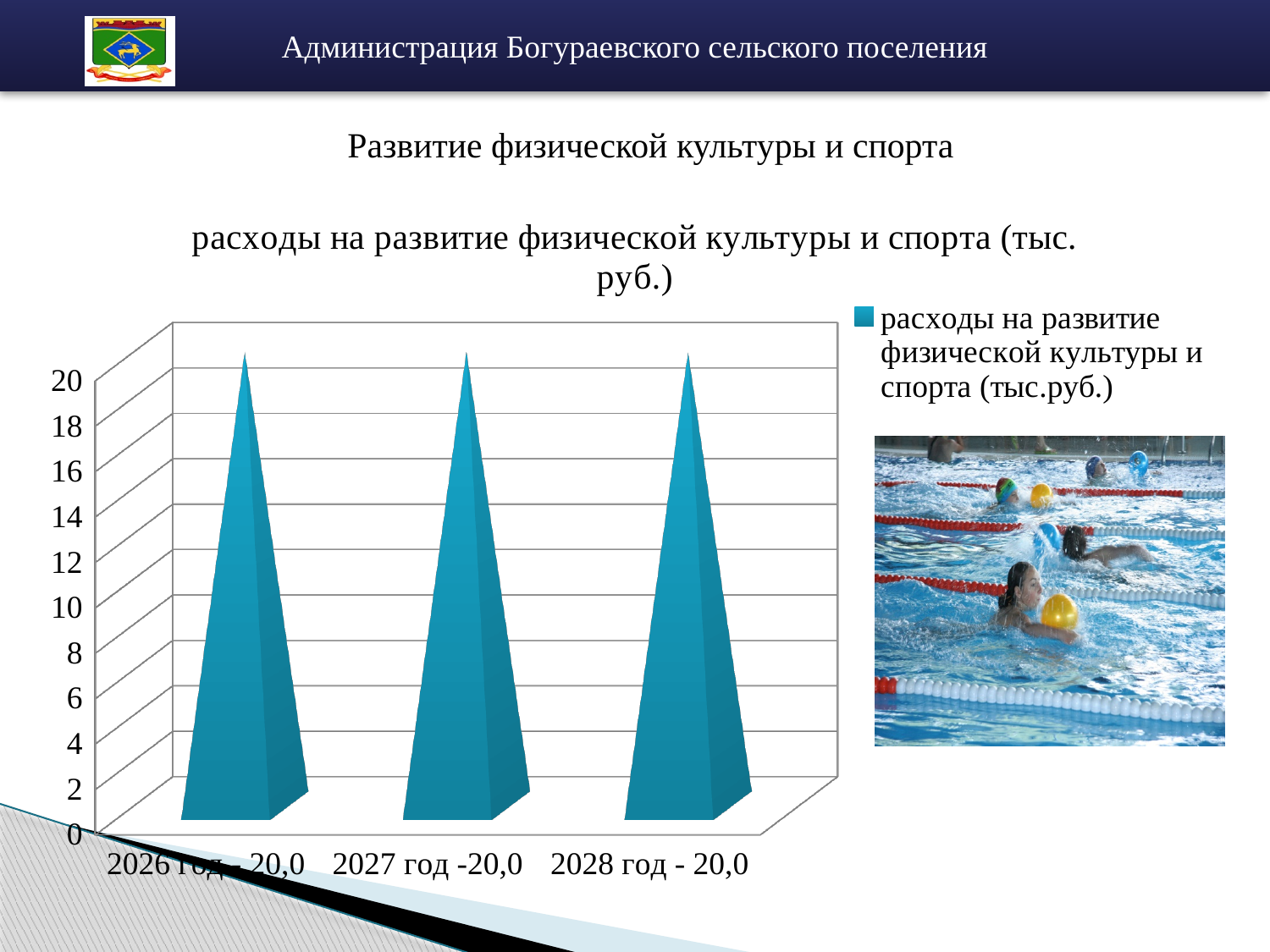
What is the value for 2028 год according to the category label? 20,0 Do the values rise, fall or stay the same from 2026 год to 2028 год? stay the same Is the value for 2027 год greater or less than 10? greater What type of chart is shown on the slide? bar chart How many series does the chart legend list? 1 What is the difference between the values for 2026 год and 2028 год? 0 What is the legend entry of the chart? расходы на развитие физической культуры и спорта (тыс.руб.) What is the highest tick value shown on the vertical axis? 20 How many categories are plotted on the chart? 3 What is the value for 2027 год according to the category label? 20,0 What is the title of the chart? расходы на развитие физической культуры и спорта (тыс. руб.) What is the value for 2026 год according to the category label? 20,0